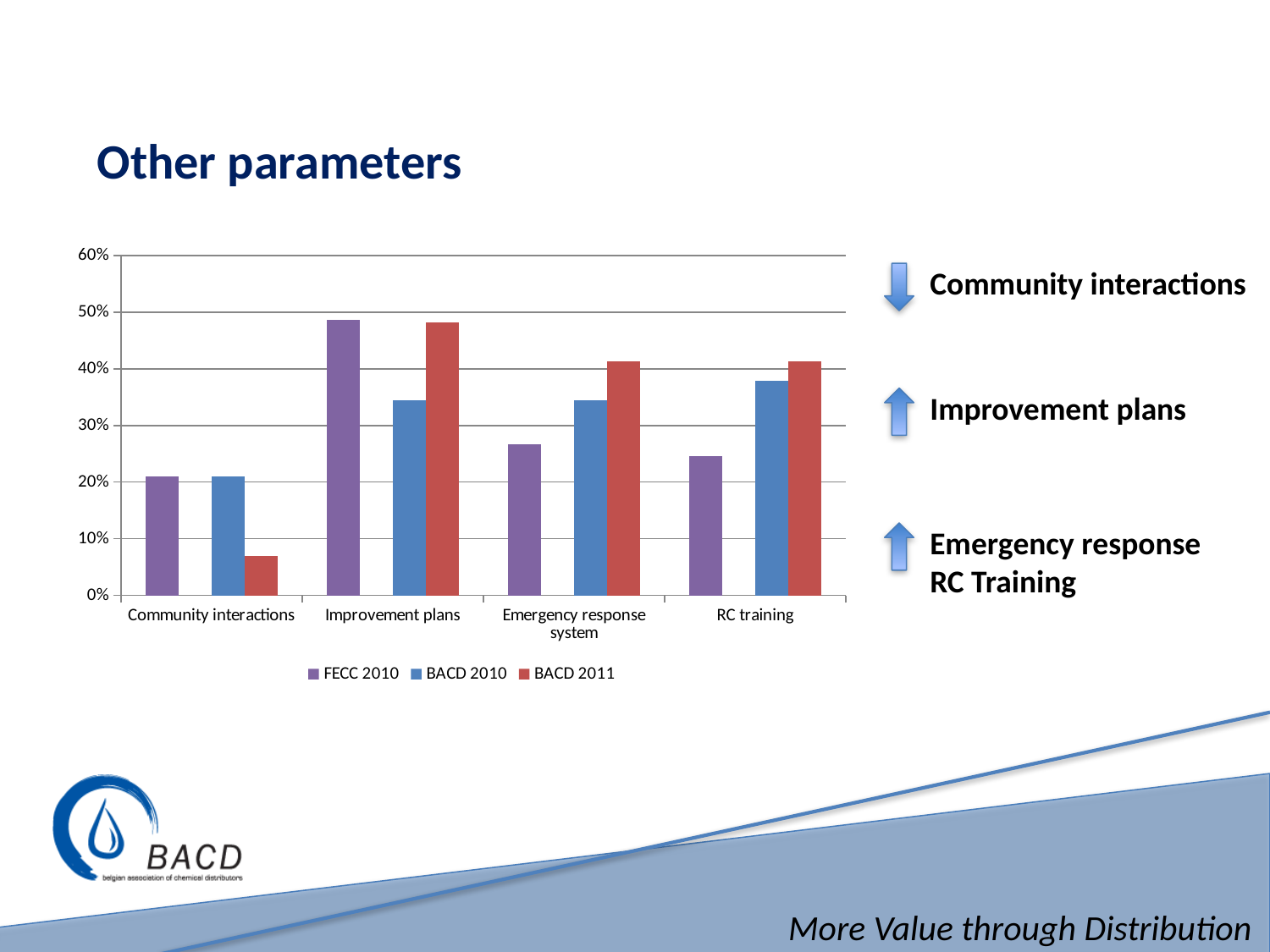
What kind of chart is shown on the slide? Bar chart For Community interactions, which is larger: the BACD 2010 value or the BACD 2011 value? BACD 2010 Is the BACD 2011 value for Community interactions greater or less than 10%? less Is the FECC 2010 value for Improvement plans greater or less than 40%? greater Which category has the lowest BACD 2011 value? Community interactions For Emergency response system, which is larger: the FECC 2010 value or the BACD 2011 value? BACD 2011 How many categories are shown on the x axis of the chart? 4 Is the BACD 2010 value for RC training greater or less than 30%? greater Which category has the highest FECC 2010 value? Improvement plans Which series are listed in the chart's legend? FECC 2010, BACD 2010, BACD 2011 Which category has the lowest BACD 2010 value? Community interactions How many series does the chart's legend list? 3